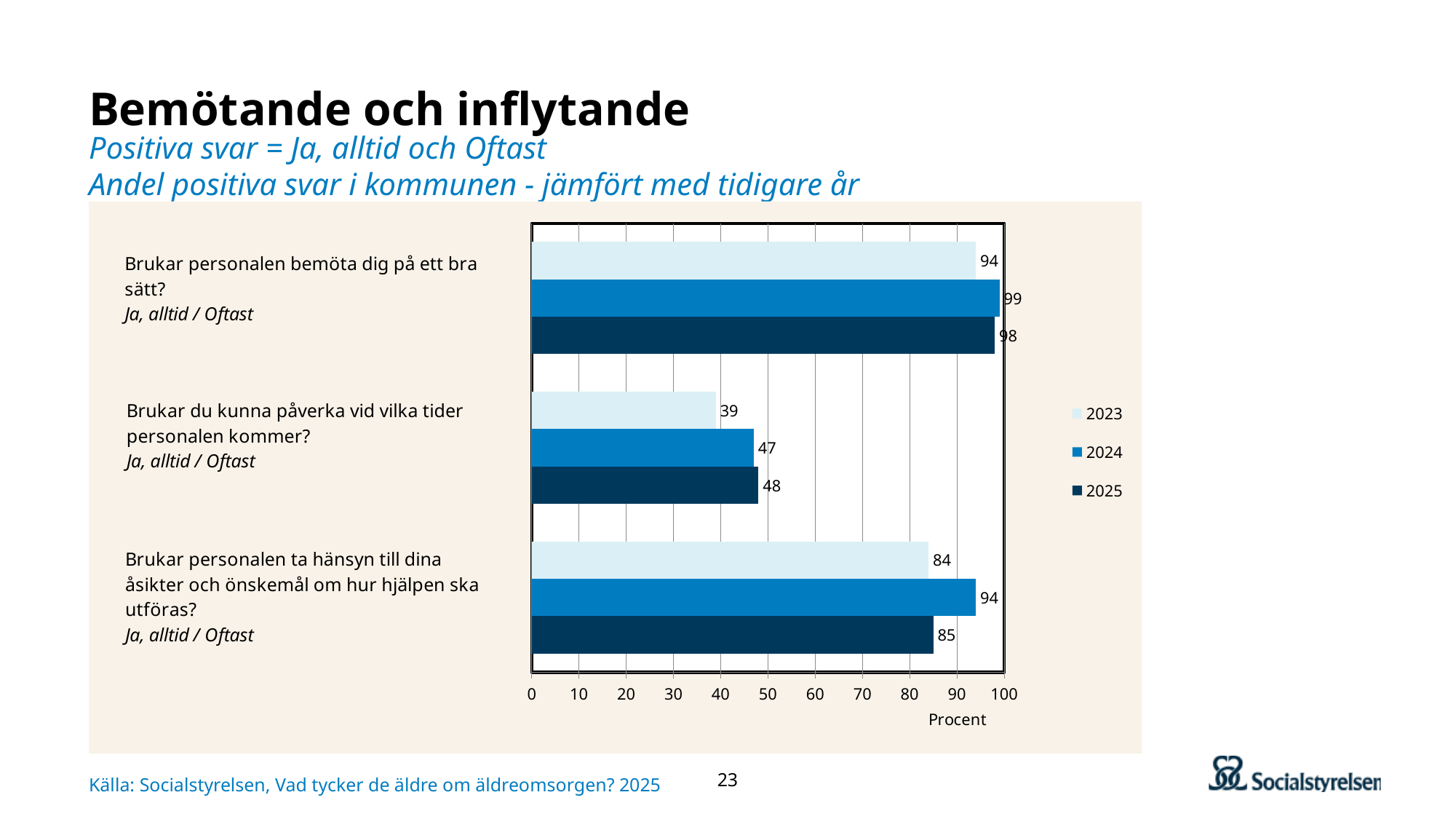
What kind of chart is shown on the slide? Bar chart What is the 2023 value for "Brukar du kunna påverka vid vilka tider personalen kommer?"? 39 What is the label on the horizontal axis of the chart? Procent What is the 2024 value for "Brukar personalen ta hänsyn till dina åsikter och önskemål om hur hjälpen ska utföras?"? 94 What is the difference between the 2024 and 2023 values for "Brukar personalen ta hänsyn till dina åsikter och önskemål om hur hjälpen ska utföras?"? 10 Which question has the lowest 2025 value? Brukar du kunna påverka vid vilka tider personalen kommer? How many series does the legend list? 3 For "Brukar personalen bemöta dig på ett bra sätt?", which year has the larger value, 2023 or 2024? 2024 How many questions (categories) are shown in the chart? 3 Which question has the highest 2024 value? Brukar personalen bemöta dig på ett bra sätt? What is the difference between the 2025 and 2023 values for "Brukar du kunna påverka vid vilka tider personalen kommer?"? 9 What is the 2025 value for "Brukar personalen bemöta dig på ett bra sätt?"? 98